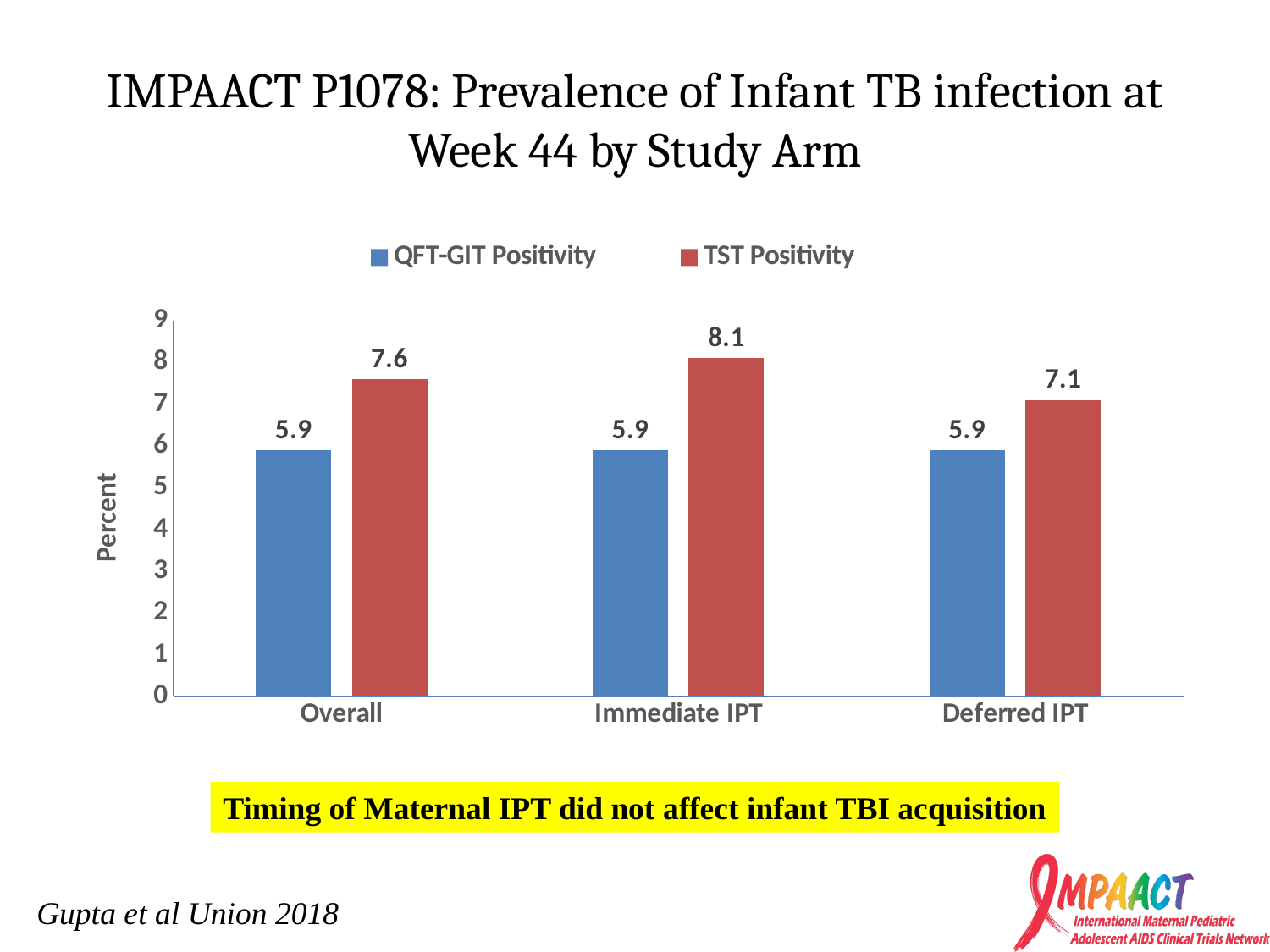
How many study arm categories are shown on the x axis? 3 Which study arm has the lowest TST Positivity? Deferred IPT What is the difference between TST Positivity for Immediate IPT and Deferred IPT? 1.0 What is the difference between TST Positivity and QFT-GIT Positivity for Immediate IPT? 2.2 What is the QFT-GIT Positivity value for Deferred IPT? 5.9 What is the label of the y axis? Percent What is the TST Positivity value for Immediate IPT? 8.1 What is the TST Positivity value for Overall? 7.6 How many series does the legend list? 2 Which study arm has the highest TST Positivity? Immediate IPT What kind of chart is shown on the slide? Bar chart Which is larger for Deferred IPT, QFT-GIT Positivity or TST Positivity? TST Positivity